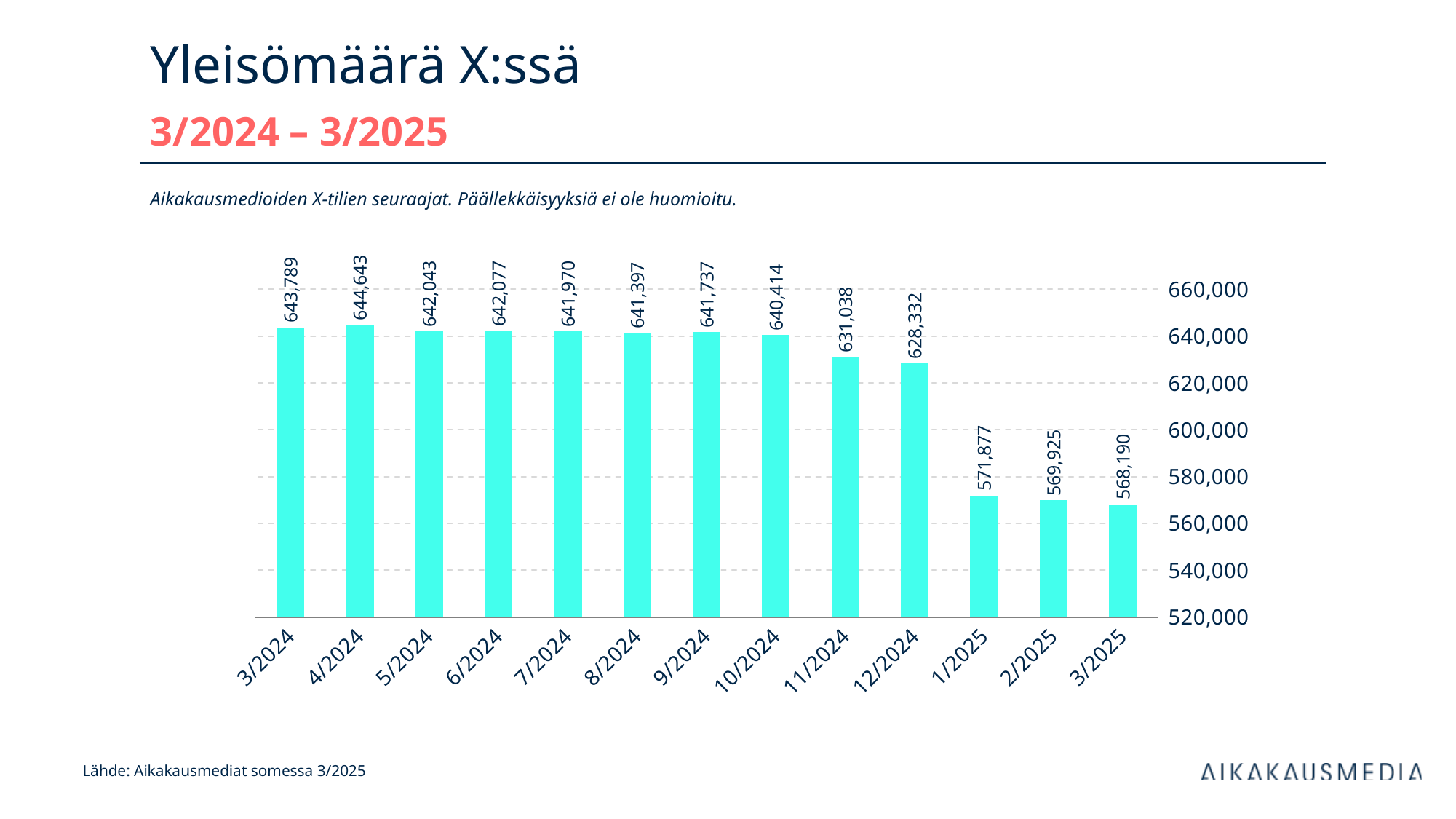
Which is larger, the value for 10/2024 or the value for 11/2024? 10/2024 Is the value for 1/2025 greater or less than 580,000? less Which month has the highest value? 4/2024 What is the value for 3/2024? 643,789 How many months are shown on the x axis? 13 Do the values generally rise or fall from 3/2024 to 3/2025? fall What is the value for 3/2025? 568,190 What is the value for 12/2024? 628,332 What is the difference between the values for 3/2024 and 3/2025? 75,599 Which month has the lowest value? 3/2025 What kind of chart is shown on the slide? bar chart What is the difference between the values for 12/2024 and 1/2025? 56,455